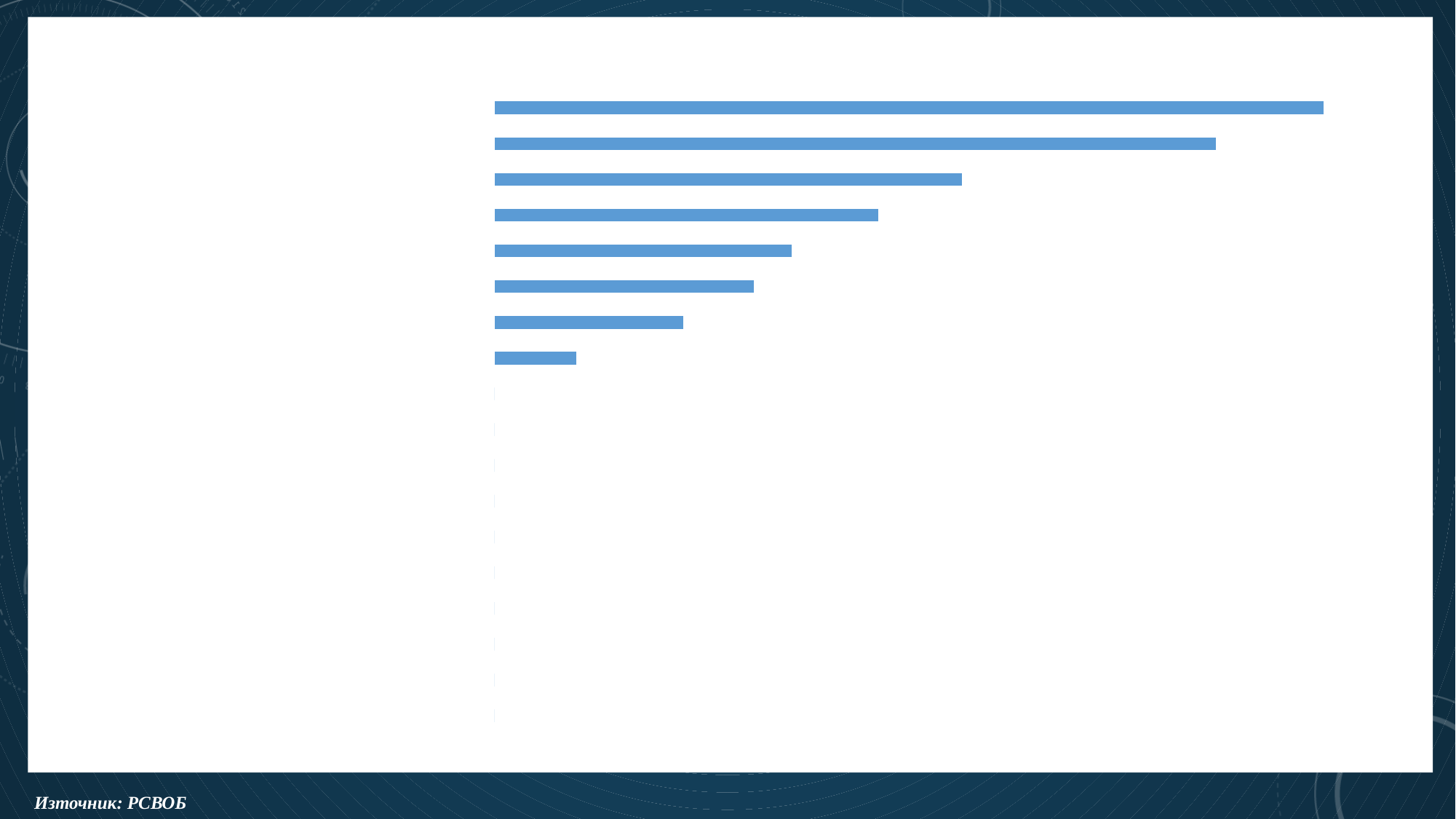
What colour are the bars in the chart? blue Are the bars in the chart horizontal or vertical? horizontal What kind of chart is shown on the slide? bar chart Do the bars get longer or shorter going from the top of the chart to the bottom? shorter